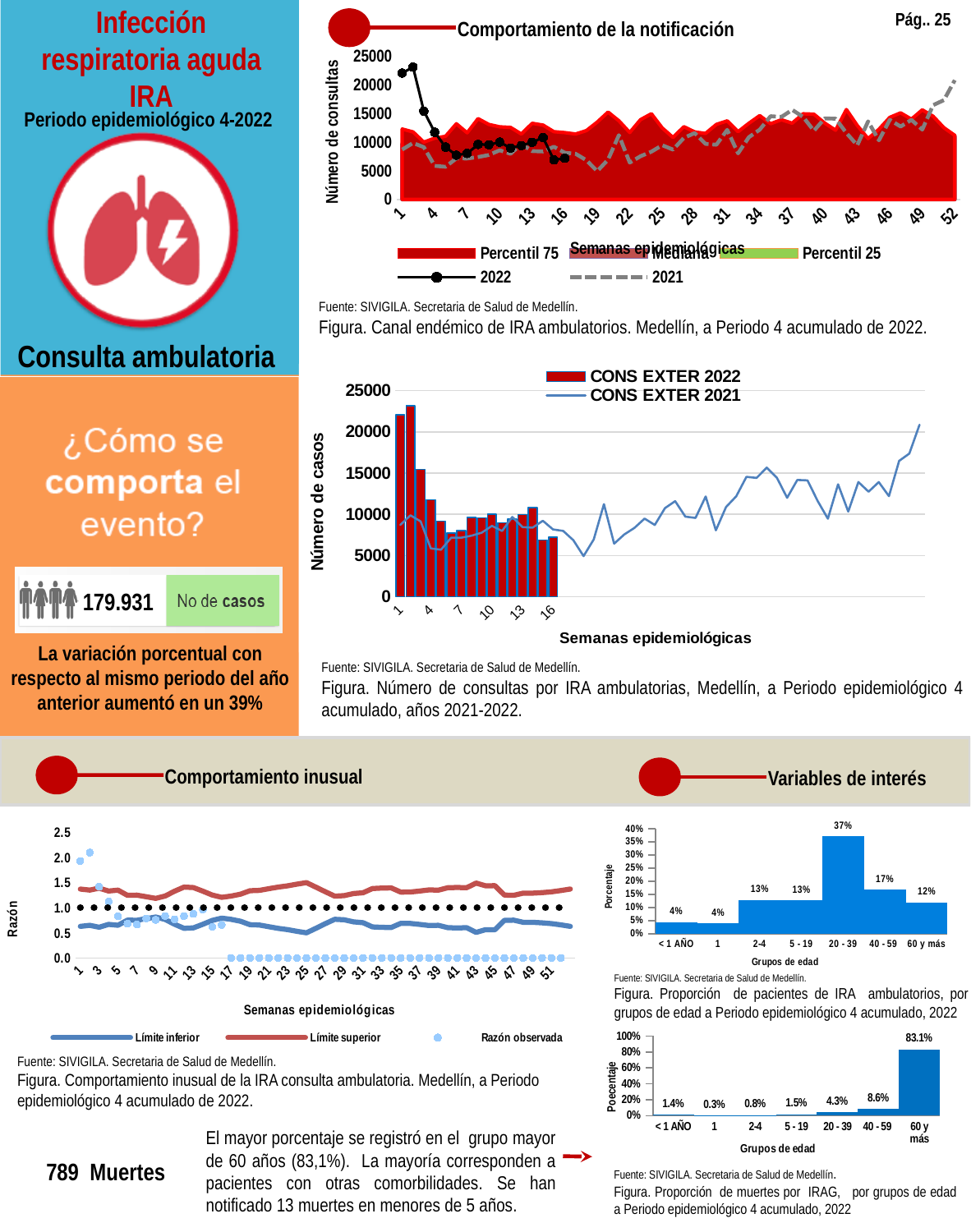
In the chart 'Proporción de pacientes de IRA ambulatorios, por grupos de edad', what is the difference between the 20 - 39 and 40 - 59 groups? 20% In the chart 'Proporción de muertes por IRAG, por grupos de edad', which is larger: the value for 5 - 19 or the value for 2-4? 5 - 19 In the chart 'Proporción de muertes por IRAG, por grupos de edad', what is the difference between the 40 - 59 and 20 - 39 groups? 4.3% In the chart 'Comportamiento inusual de la IRA consulta ambulatoria', how many entries does the legend list? 3 What kind of chart is 'Proporción de muertes por IRAG, por grupos de edad'? bar chart In the chart 'Número de consultas por IRA ambulatorias', is the CONS EXTER 2022 value at week 2 greater or less than 20000? greater In the chart 'Proporción de pacientes de IRA ambulatorios, por grupos de edad', what is the value for the 20 - 39 age group? 37% In the chart 'Proporción de pacientes de IRA ambulatorios, por grupos de edad', which age group has the highest proportion? 20 - 39 In the chart 'Proporción de muertes por IRAG, por grupos de edad', which age group has the lowest proportion? 1 In the chart 'Proporción de pacientes de IRA ambulatorios, por grupos de edad', how many age groups are shown on the x axis? 7 In the chart 'Proporción de muertes por IRAG, por grupos de edad', what is the value for the '60 y más' group? 83.1% In the chart 'Canal endémico de IRA ambulatorios', how many series does the legend list? 5